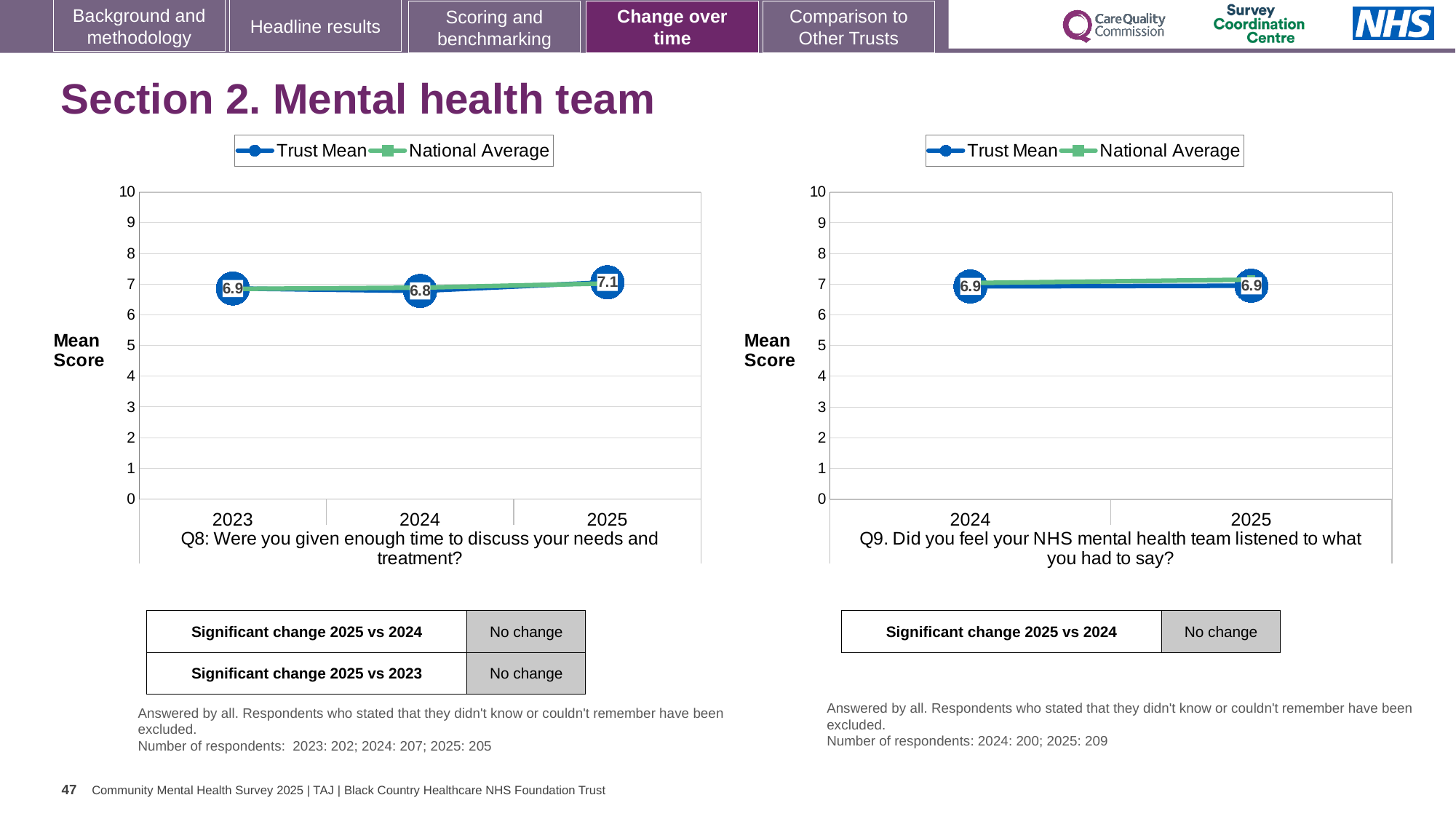
In the Q9 chart on the right, what is the Trust Mean for 2025? 6.9 In the Q8 chart on the left, what is the difference between the Trust Mean for 2025 and 2024? 0.3 In the Q8 chart on the left, what is the Trust Mean for 2023? 6.9 In the Q8 chart on the left, which year has the lowest Trust Mean? 2024 How many series does the legend of the Q9 chart on the right list? 2 In the Q8 chart on the left, what is the Trust Mean for 2024? 6.8 In the Q8 chart on the left, is the Trust Mean higher in 2025 or in 2024? 2025 How many years are plotted on the x axis of the Q8 chart on the left? 3 In the Q8 chart on the left, what is the Trust Mean for 2025? 7.1 What kind of chart is the Q8 chart on the left? Line chart In the Q9 chart on the right, is the National Average for 2025 greater or less than 8? less In the Q8 chart on the left, which year has the highest Trust Mean? 2025